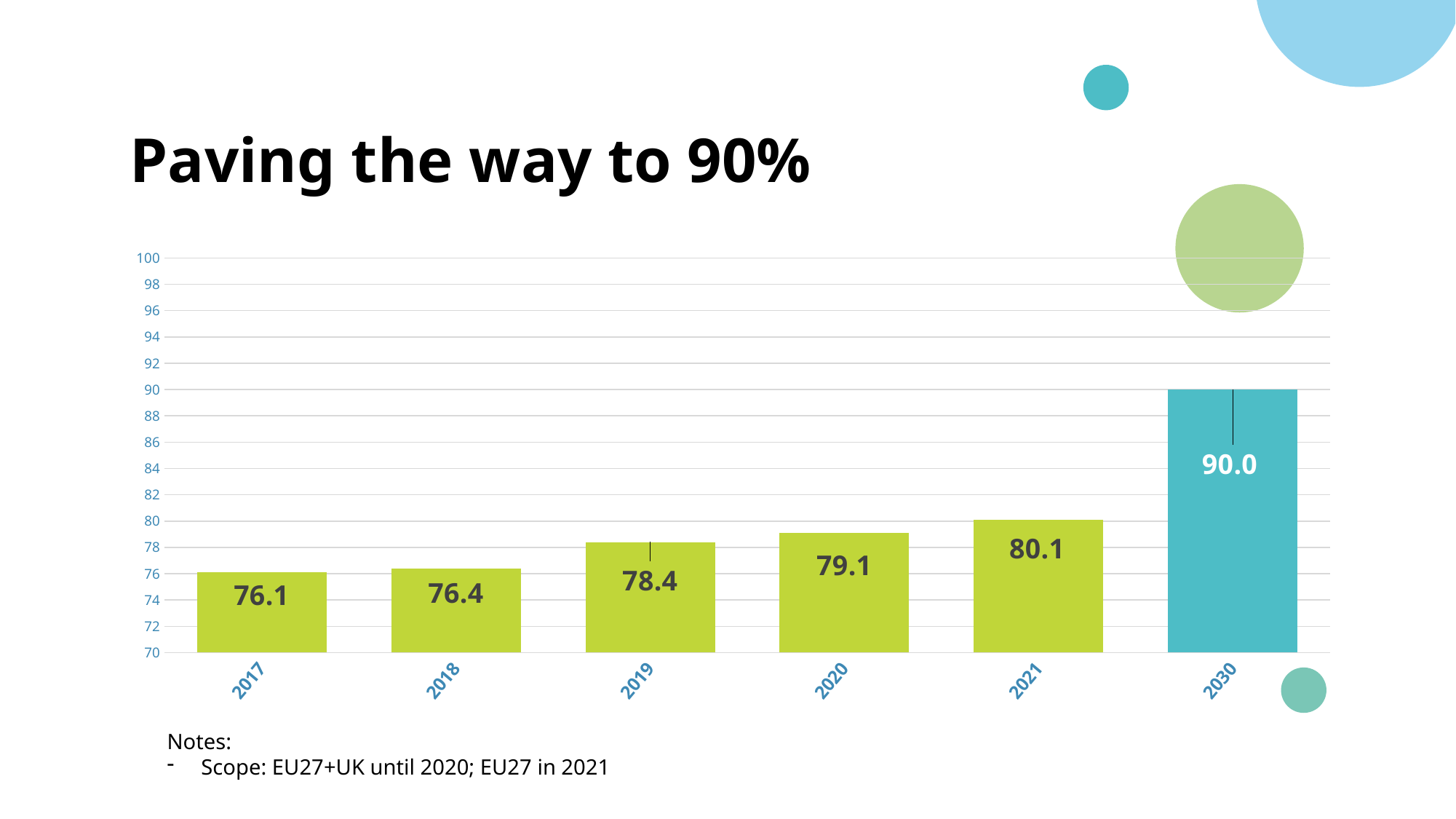
Which is larger, the value for 2019 or the value for 2020? 2020 Which category has the lowest value? 2017 How many bars are shown in the chart? 6 What is the value for 2019? 78.4 What is the value for 2021? 80.1 What is the value for 2030? 90.0 Do the values rise or fall from 2017 to 2030? Rise What is the difference between the values for 2030 and 2021? 9.9 What is the difference between the values for 2020 and 2018? 2.7 What is the value for 2017? 76.1 What kind of chart is shown on the slide? Bar chart Which category has the highest value? 2030